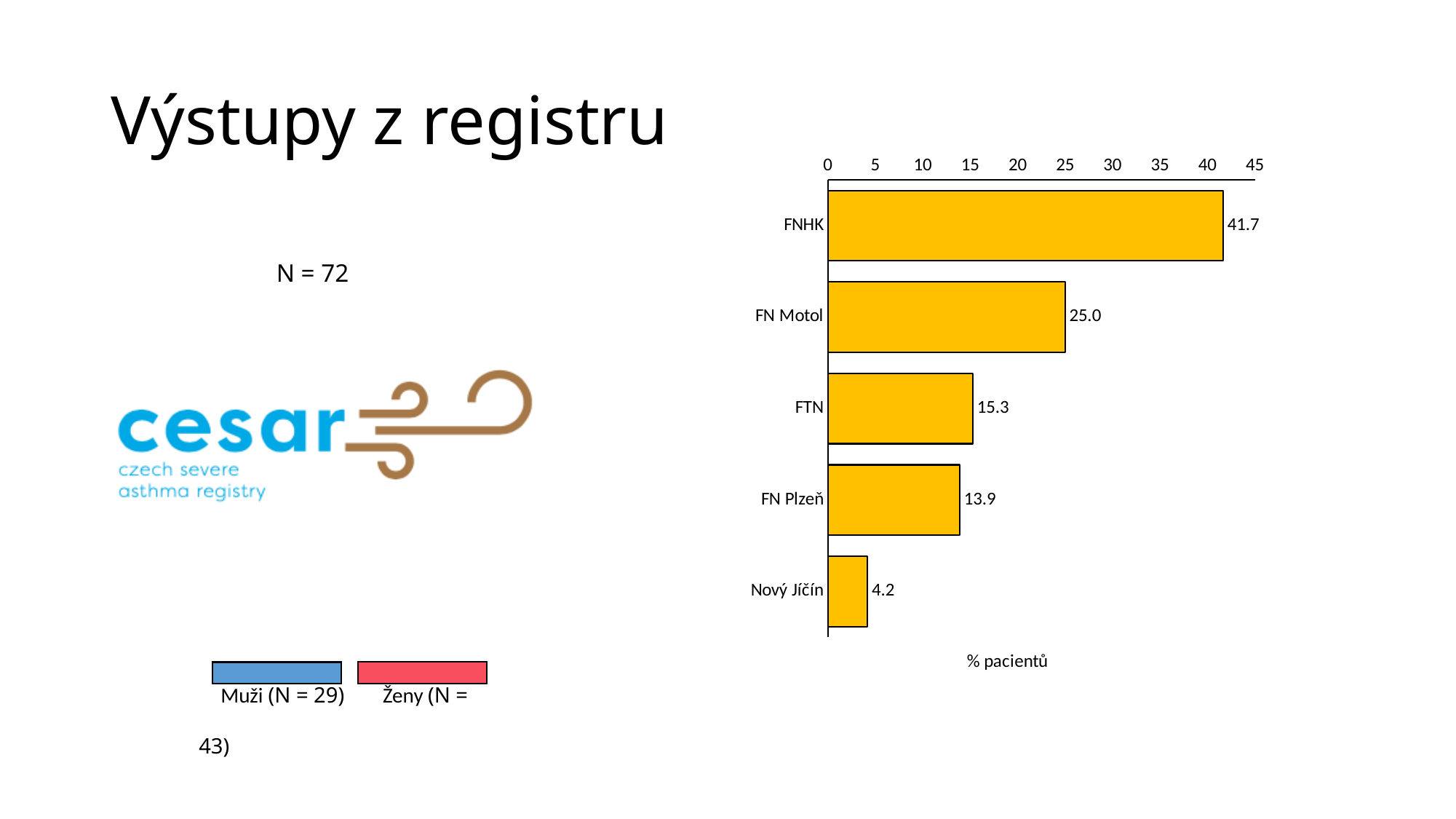
Which category has the lowest value in the bar chart? Nový Jíčín What is the value for FN Motol in the bar chart? 25.0 What is the value for FNHK in the bar chart? 41.7 What is the difference between the values for FTN and FN Plzeň? 1.4 What kind of chart is shown on the slide? bar chart What is the difference between the values for FNHK and FN Motol? 16.7 What is the value for Nový Jíčín in the bar chart? 4.2 Which category has the highest value in the bar chart? FNHK How many categories are shown in the bar chart? 5 What is the label of the value axis in the bar chart? % pacientů Which has a larger value, FN Motol or FTN? FN Motol What is the value for FTN in the bar chart? 15.3